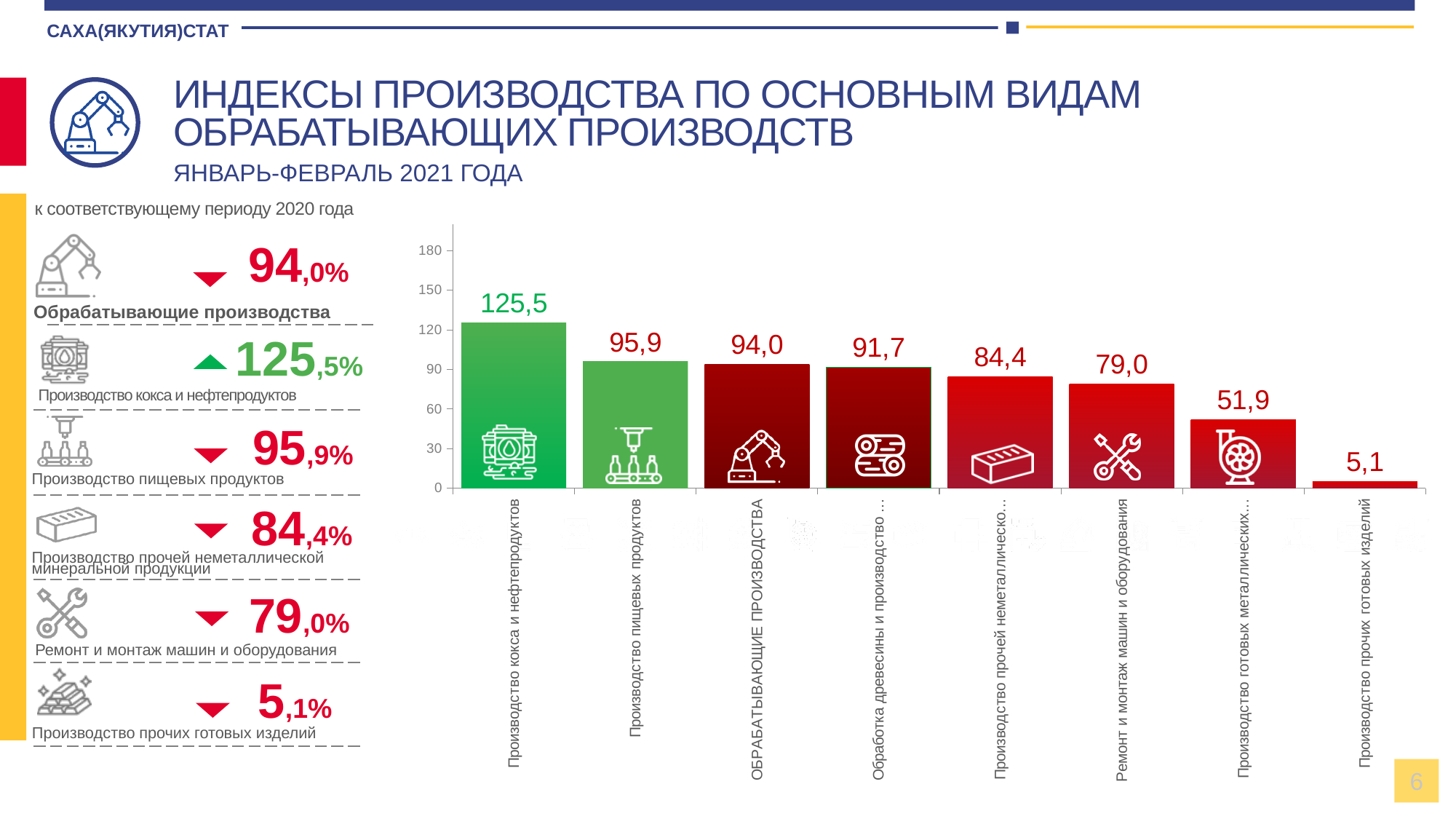
How many bars are shown in the chart? 8 What is the value for Производство пищевых продуктов? 95,9 What kind of chart is shown on the slide? Bar chart Which category has the highest value? Производство кокса и нефтепродуктов What is the difference between the values for Производство кокса и нефтепродуктов and Производство пищевых продуктов? 29,6 Do the values rise or fall from left to right along the x axis? Fall Which category has the lowest value? Производство прочих готовых изделий Which is larger: the value for Ремонт и монтаж машин и оборудования or the value for Производство прочих готовых изделий? Ремонт и монтаж машин и оборудования What is the value for Ремонт и монтаж машин и оборудования? 79,0 What is the value for ОБРАБАТЫВАЮЩИЕ ПРОИЗВОДСТВА? 94,0 What is the value for Производство прочих готовых изделий? 5,1 What is the value for Производство кокса и нефтепродуктов? 125,5